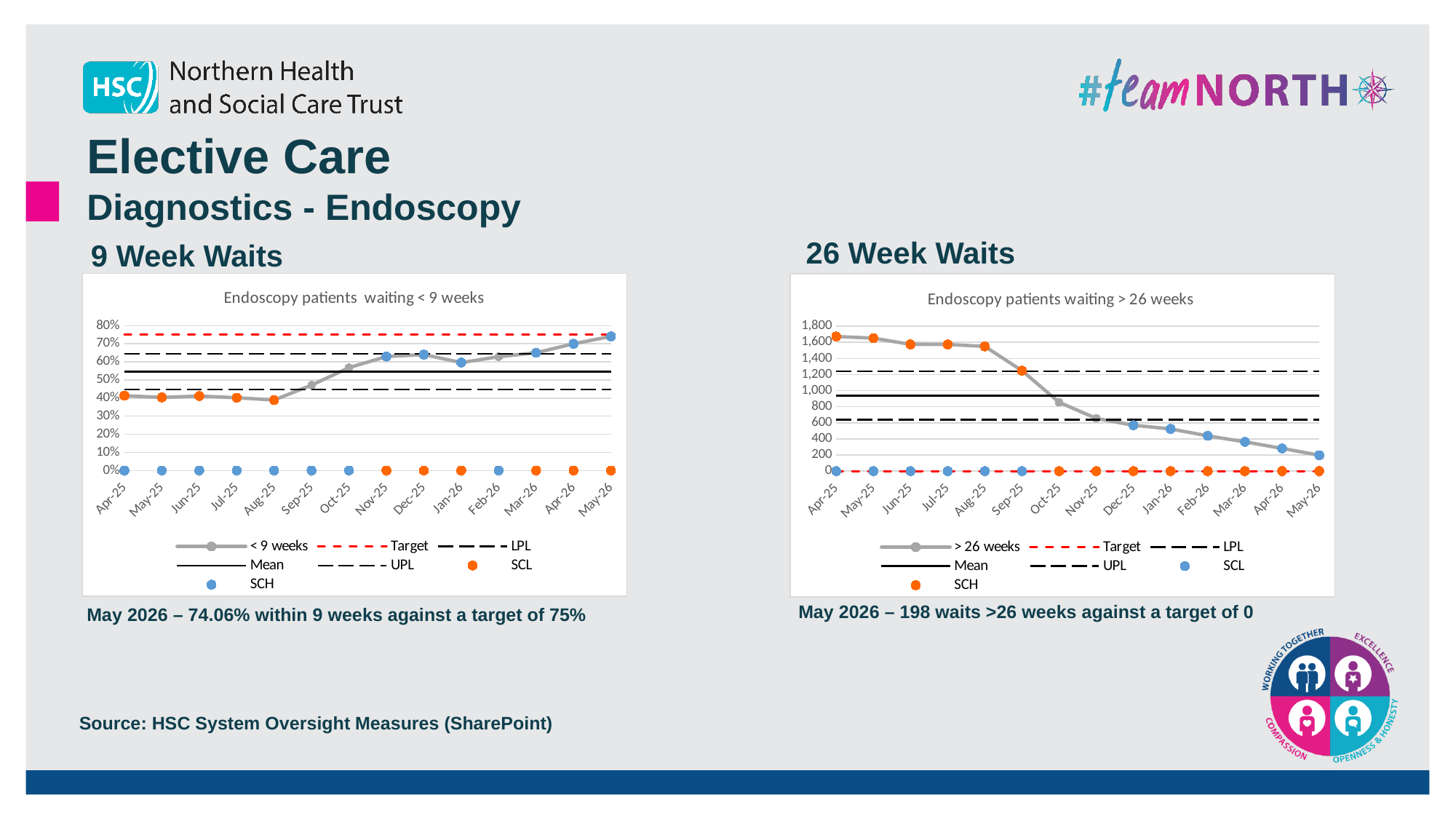
In the 'Endoscopy patients waiting < 9 weeks' chart, is the < 9 weeks value for Apr-25 greater or less than 50%? less In the 'Endoscopy patients waiting < 9 weeks' chart, which month has the highest < 9 weeks value? May-26 In the 'Endoscopy patients waiting > 26 weeks' chart, do the > 26 weeks values generally rise or fall from Apr-25 to May-26? fall How many series does the legend of the 'Endoscopy patients waiting > 26 weeks' chart list? 7 In the 'Endoscopy patients waiting < 9 weeks' chart, how many months are plotted on the x axis? 14 What type of chart is the 'Endoscopy patients waiting < 9 weeks' chart? line chart In the 'Endoscopy patients waiting > 26 weeks' chart, what is the value for May-26? 198 In the 'Endoscopy patients waiting > 26 weeks' chart, which month has the lowest > 26 weeks value? May-26 In the 'Endoscopy patients waiting > 26 weeks' chart, which is higher, the > 26 weeks value for Sep-25 or for Dec-25? Sep-25 In the 'Endoscopy patients waiting > 26 weeks' chart, is the > 26 weeks value for Oct-25 greater or less than 1,000? less In the 'Endoscopy patients waiting < 9 weeks' chart, do the < 9 weeks values generally rise or fall from Apr-25 to May-26? rise In the 'Endoscopy patients waiting < 9 weeks' chart, what is the value for May-26? 74.06%